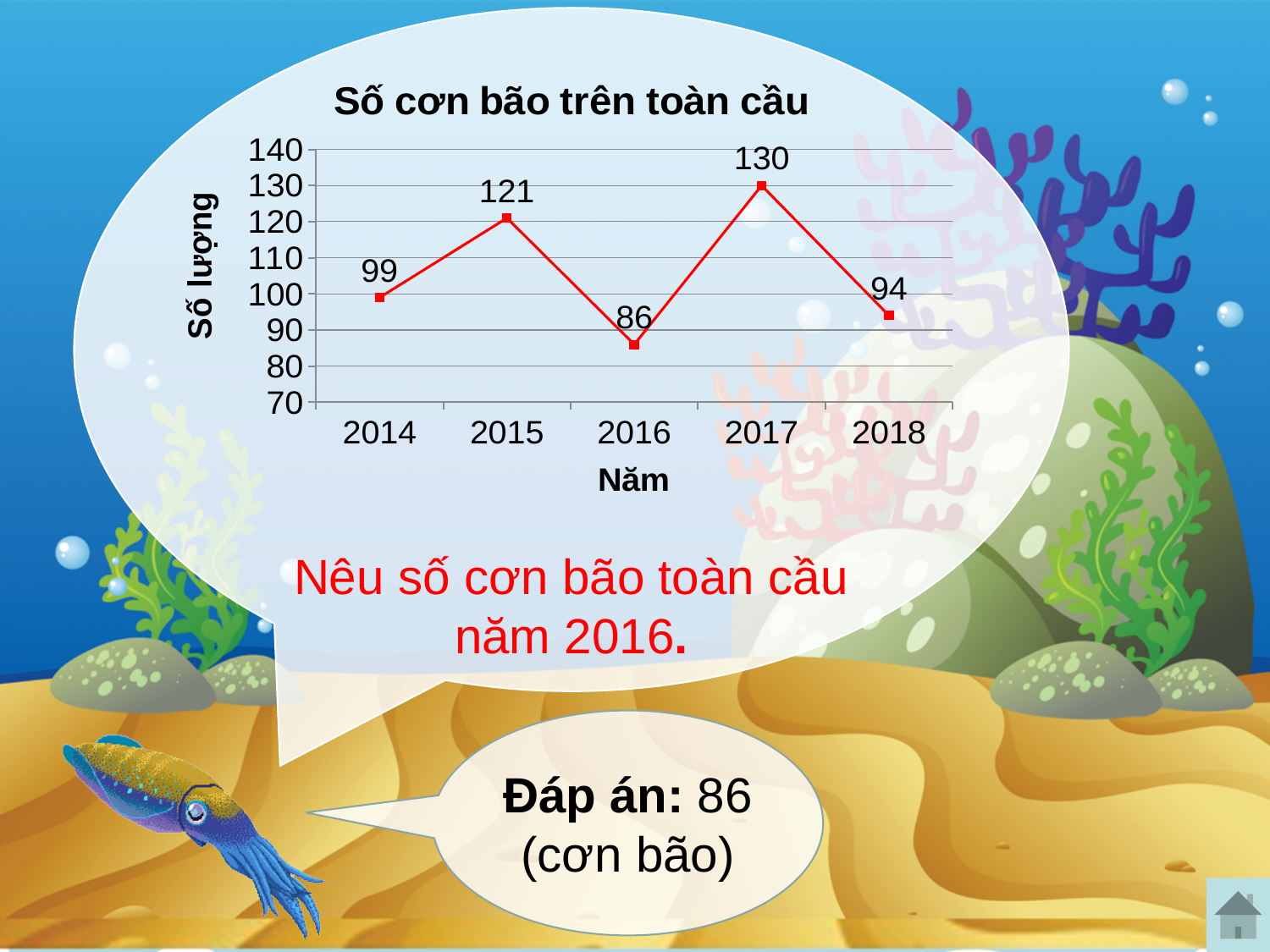
Which year has the highest number of storms? 2017 What is the number of storms in 2014? 99 What is the difference between the number of storms in 2015 and 2014? 22 What is the title of the chart? Số cơn bão trên toàn cầu What is the number of storms in 2017? 130 Which year has more storms, 2015 or 2018? 2015 Is the value for 2018 greater or less than 100? less What is the number of storms in 2016? 86 What kind of chart is shown on the slide? line chart What is the difference between the number of storms in 2017 and 2016? 44 Which year has the lowest number of storms? 2016 How many years are shown on the chart? 5